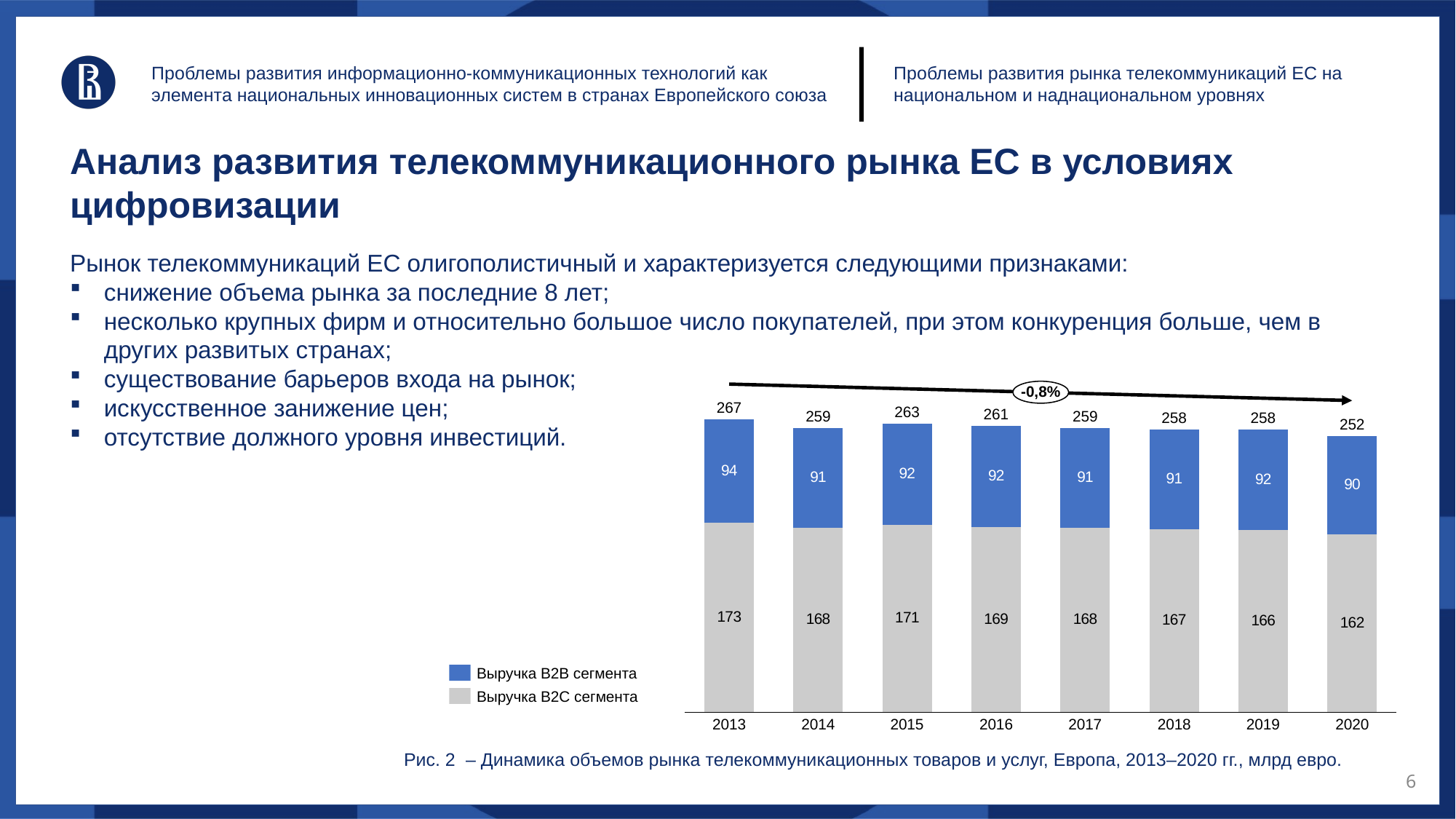
What is the B2C segment revenue (Выручка B2C сегмента) in 2015? 171 Do the total market volumes generally rise or fall from 2013 to 2020? fall What type of chart is shown on the slide? stacked bar chart How many years are shown on the x axis of the chart? 8 Which year has the lowest total market volume? 2020 What percentage change is written on the arrow above the bars? -0,8% Which year has the highest B2B segment revenue? 2013 What is the B2B segment revenue (Выручка B2B сегмента) in 2020? 90 Which is larger: the B2B segment revenue in 2014 or in 2015? 2015 What is the difference between the B2C segment revenue in 2013 and in 2020? 11 How many series does the legend list? 2 What is the total market volume shown above the bar for 2013? 267